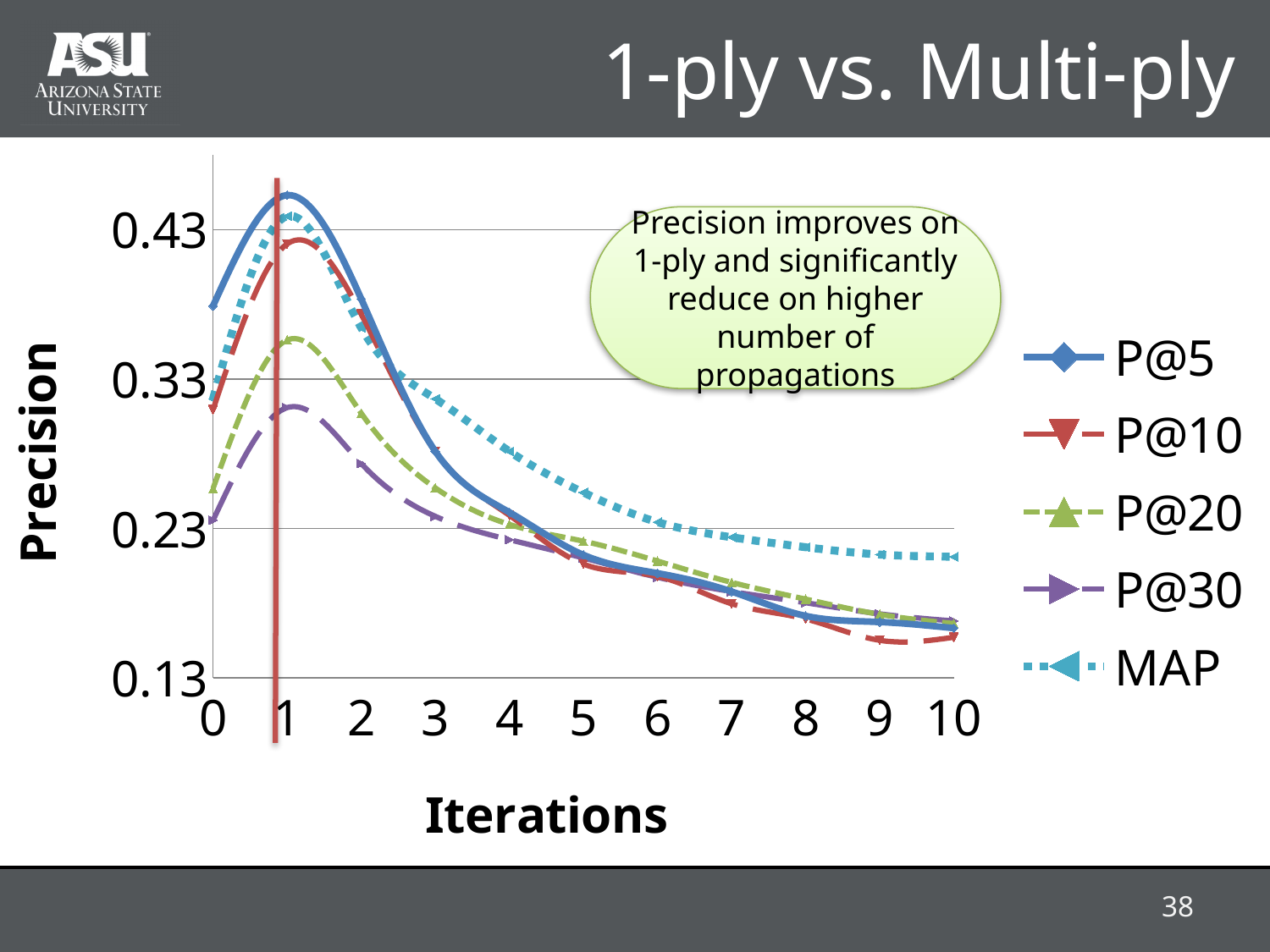
Which series has the highest precision at iteration 1? P@5 How many series does the legend list? 5 Is the value for P@5 at iteration 1 greater or less than 0.43? greater Which series has the lowest precision at iteration 1? P@30 How many iteration values are marked along the x axis? 11 What is the label of the y axis? Precision Is the value for P@30 at iteration 1 greater or less than 0.33? less Is the value for MAP at iteration 10 greater or less than 0.23? less At iteration 6, which is higher: MAP or P@30? MAP Which series has the highest precision at iteration 10? MAP What kind of chart is shown on the slide? line chart From iteration 1 to iteration 10, does the P@5 series rise or fall? fall